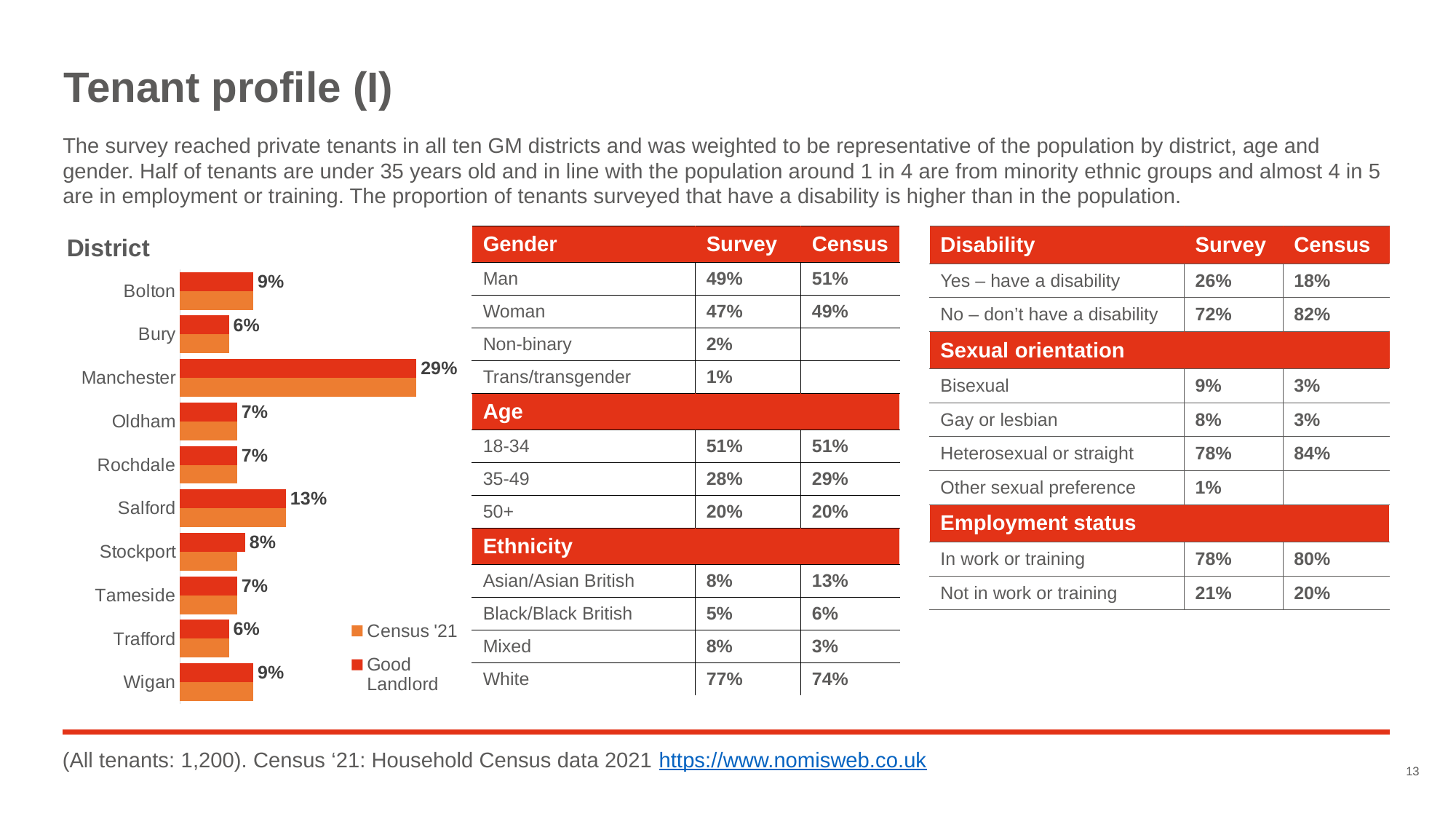
In the District chart, what is the Good Landlord value for Manchester? 29% In the District chart, what is the difference between the Good Landlord values for Bolton and Bury? 3% In the District chart, what is the Good Landlord value for Salford? 13% What kind of chart is the District chart? bar chart In the District chart, which district has the highest Good Landlord value? Manchester How many series does the legend of the District chart list? 2 What are the two series named in the legend of the District chart? Census '21 and Good Landlord How many districts are shown in the District chart? 10 In the District chart, which has the larger Good Landlord value, Salford or Stockport? Salford In the District chart, what is the difference between the Good Landlord values for Manchester and Salford? 16% In the District chart, what is the Good Landlord value for Bury? 6% In the District chart, what is the Good Landlord value for Stockport? 8%